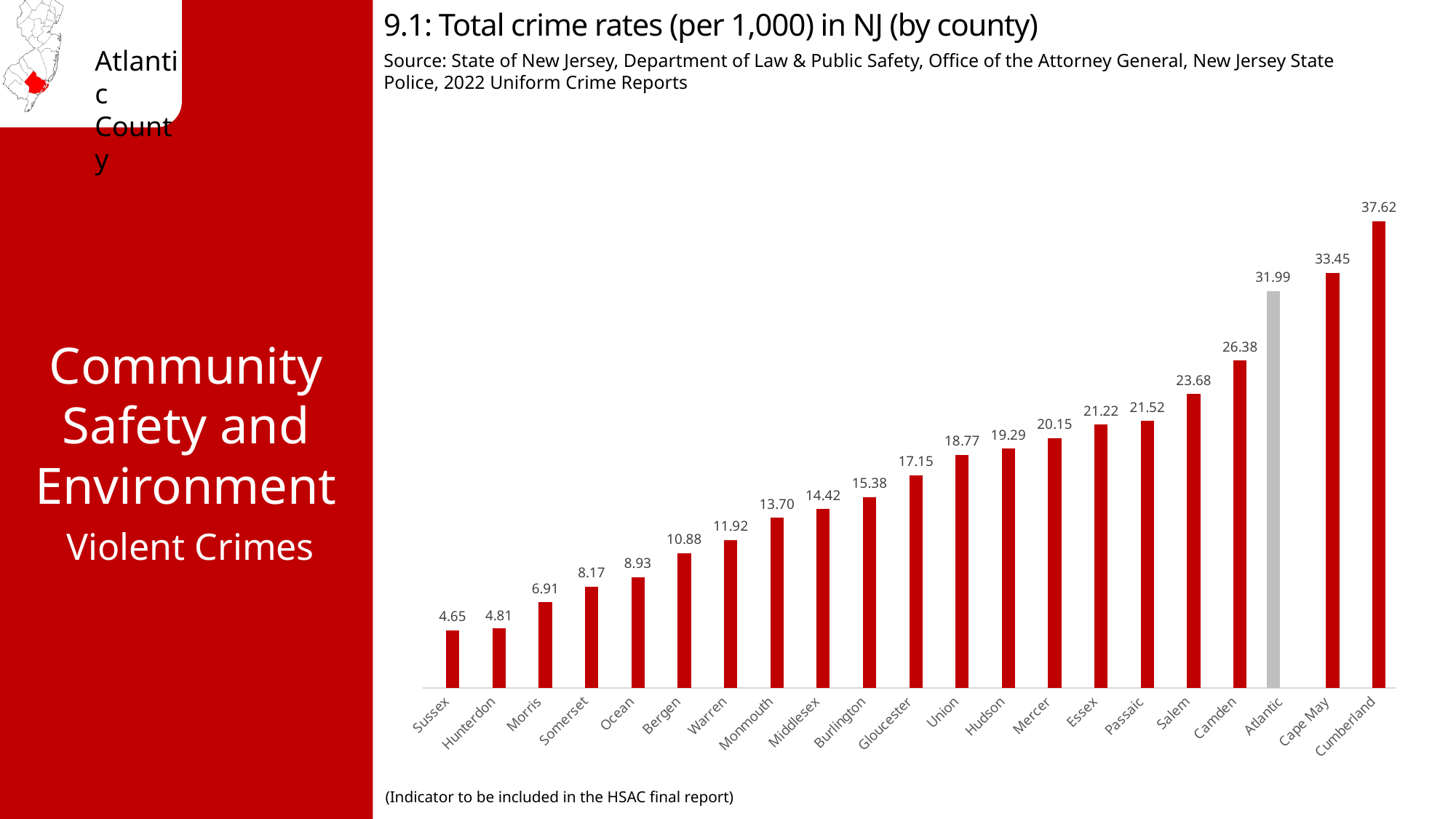
Which county has a higher total crime rate, Morris or Ocean? Ocean Which county has the highest total crime rate on the chart? Cumberland What is the total crime rate (per 1,000) for Hudson county? 19.29 What is the total crime rate (per 1,000) for Bergen county? 10.88 How many counties are shown on the chart? 21 What is the difference between Atlantic's and Camden's total crime rates? 5.61 What is the total crime rate (per 1,000) for Atlantic county? 31.99 Which county has the lowest total crime rate on the chart? Sussex What is the difference between Cumberland's and Atlantic's total crime rates? 5.63 Which county has a higher total crime rate, Cape May or Atlantic? Cape May What kind of chart is used to show the total crime rates by county? Bar chart Do the total crime rates rise or fall moving from left to right along the x axis? Rise